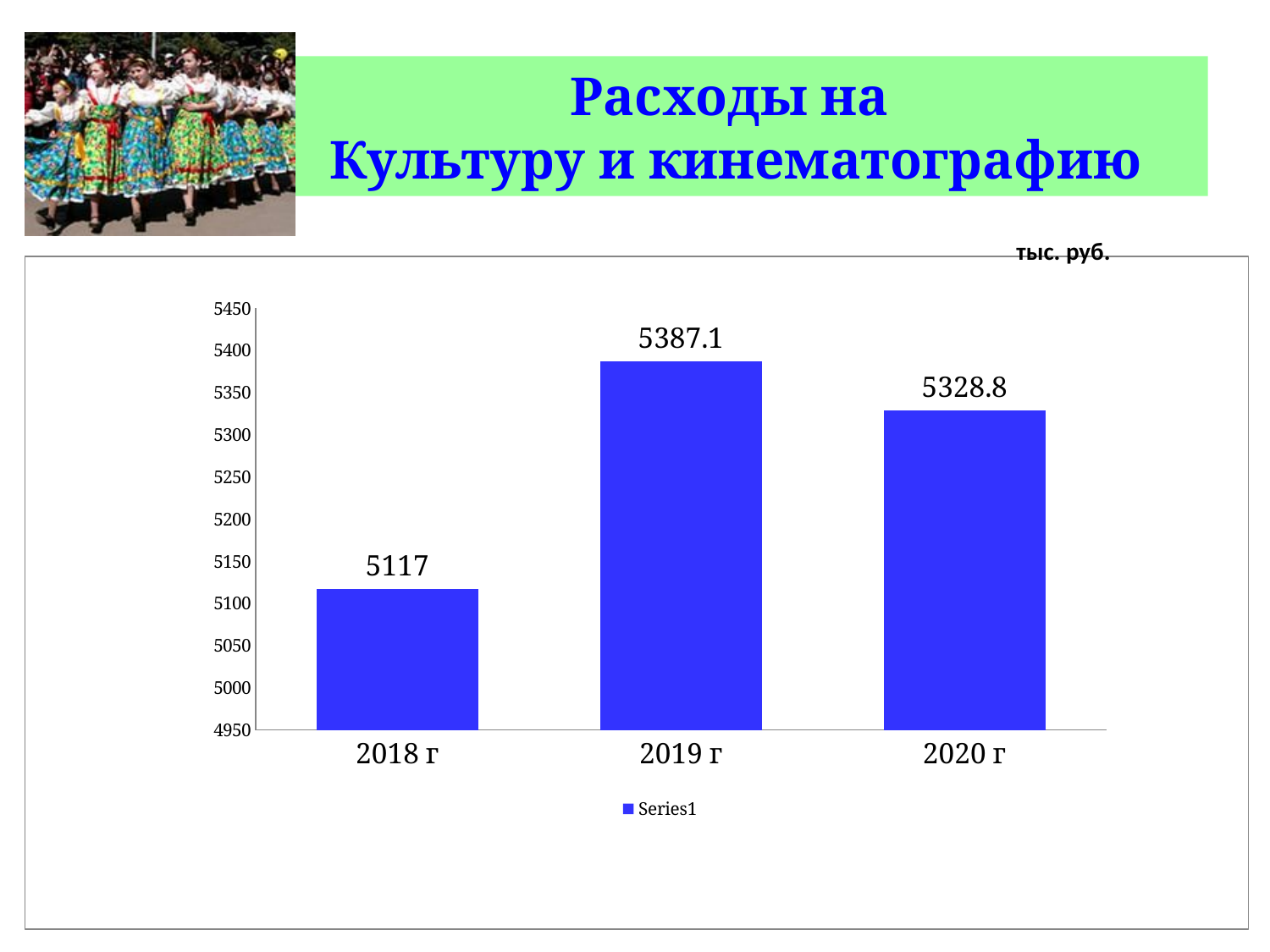
Which year has the lowest value? 2018 г Is the value for 2018 г greater or less than 5150? less What unit is indicated above the chart? тыс. руб. What is the difference between the values for 2019 г and 2018 г? 270.1 Which is larger, the value for 2020 г or the value for 2018 г? 2020 г What is the difference between the values for 2019 г and 2020 г? 58.3 What is the value for 2019 г? 5387.1 Which year has the highest value? 2019 г How many years are shown on the x axis? 3 What kind of chart is shown on the slide? bar chart What is the value for 2018 г? 5117 What is the value for 2020 г? 5328.8